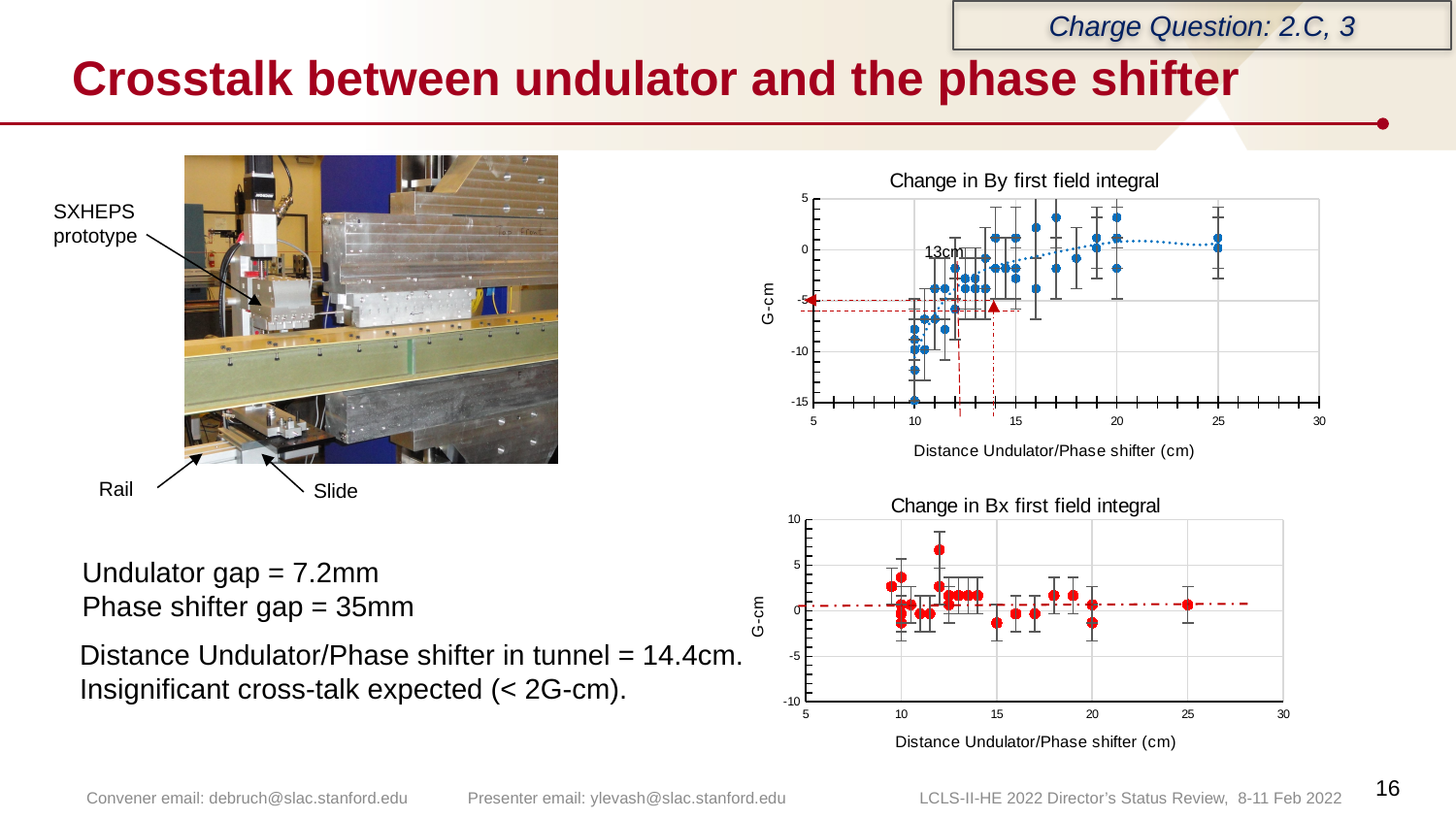
In the 'Change in Bx first field integral' chart, is the value at 25 cm greater or less than -5? greater In the 'Change in By first field integral' chart, is the value at 25 cm larger than the lowest value at 10 cm? yes What kind of chart is 'Change in Bx first field integral'? scatter chart What kind of chart is 'Change in By first field integral'? scatter chart What is the x-axis label of the 'Change in Bx first field integral' chart? Distance Undulator/Phase shifter (cm) In the 'Change in By first field integral' chart, are the values at 10 cm greater or less than 0? less What is the title of the upper chart on the right of the slide? Change in By first field integral In the 'Change in By first field integral' chart, is the value at 25 cm greater or less than -5? greater In the 'Change in By first field integral' chart, do the values rise or fall as the distance increases from 10 cm to 25 cm? rise In the 'Change in Bx first field integral' chart, do the values show a strong rising trend, a strong falling trend, or stay roughly flat as distance increases? roughly flat